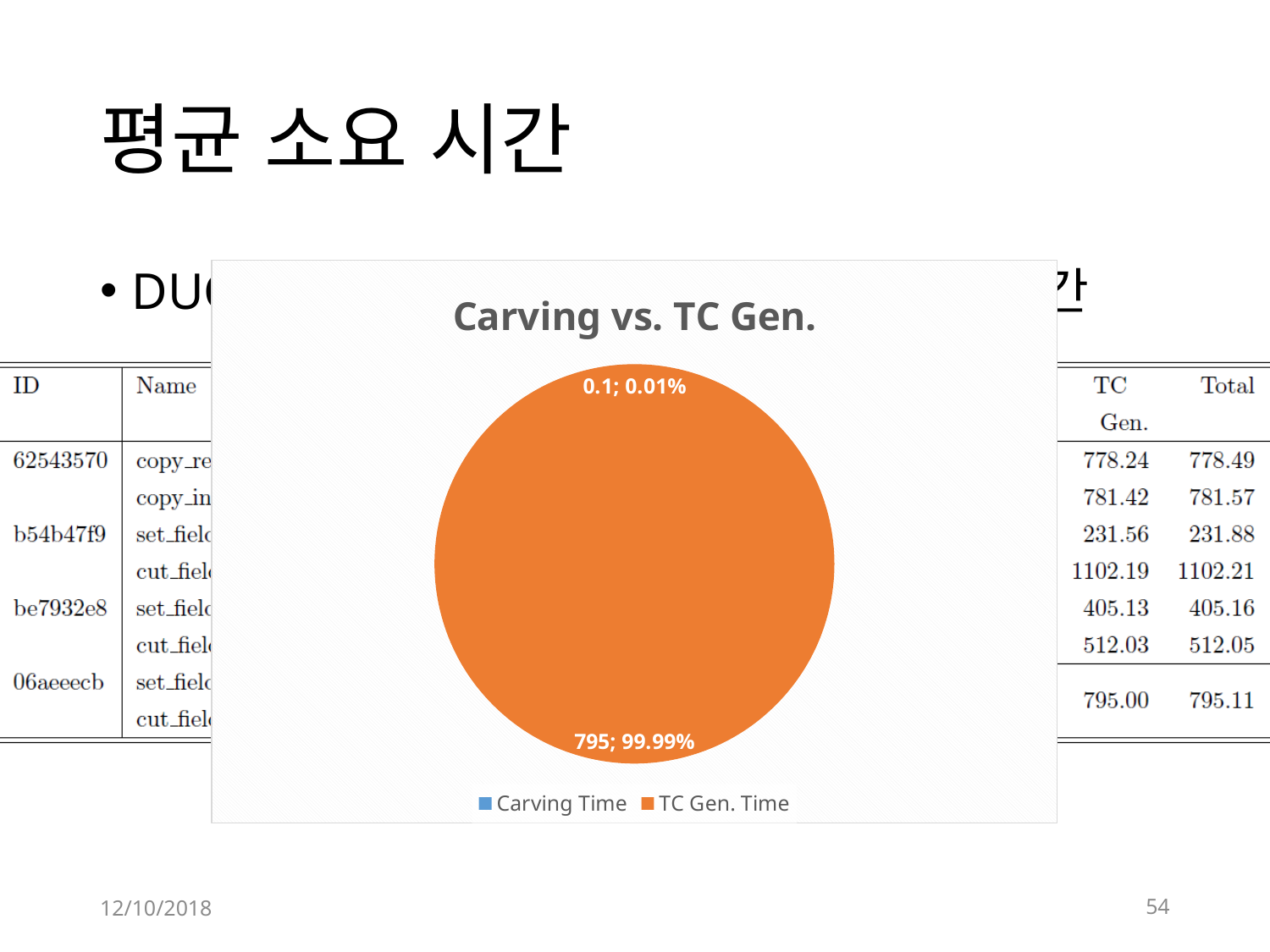
What share of the pie does Carving Time take? 0.01% What is the title of the pie chart? Carving vs. TC Gen. Which slice of the pie chart is the largest? TC Gen. Time How many entries does the chart legend list? 2 Which is larger, Carving Time or TC Gen. Time? TC Gen. Time Which slice of the pie chart is the smallest? Carving Time What value is shown for TC Gen. Time in the pie chart? 795 What share of the pie does TC Gen. Time take? 99.99% How many slices does the pie chart have? 2 What value is shown for Carving Time in the pie chart? 0.1 What colour is the TC Gen. Time slice in the pie chart? orange What kind of chart is shown on the slide? pie chart